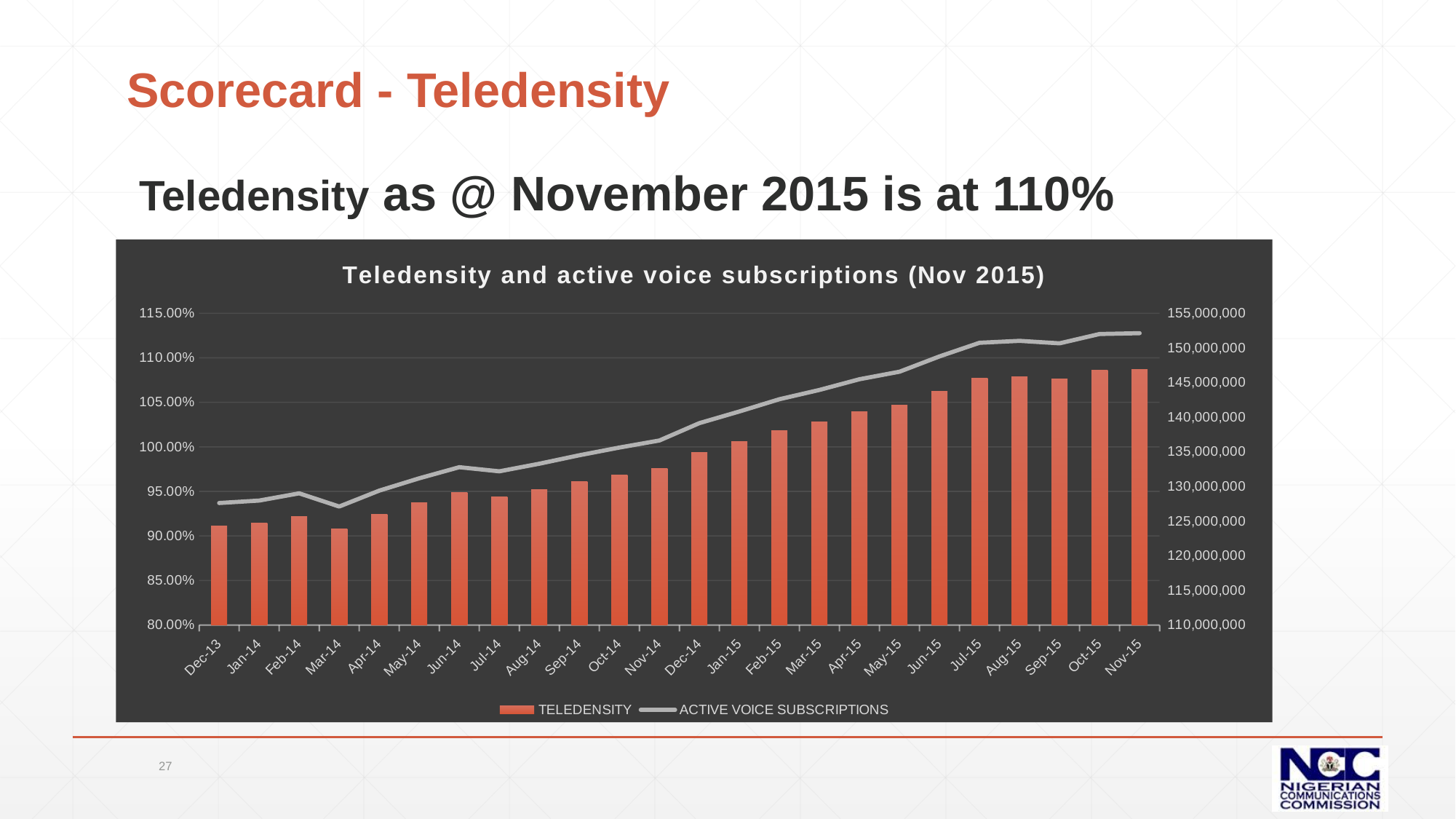
What type of chart is shown on the slide? Combination bar and line chart Is the active voice subscriptions value for Dec-13 greater or less than 130,000,000? less What is the title of the chart? Teledensity and active voice subscriptions (Nov 2015) Is the teledensity value for Nov-15 greater or less than 105.00%? greater Does teledensity generally rise or fall from Dec-13 to Nov-15? rise Is the teledensity value for Dec-13 greater or less than 95.00%? less Which series is drawn as a line in the chart? ACTIVE VOICE SUBSCRIPTIONS How many series does the chart legend list? 2 Which month has the higher teledensity, Mar-14 or Jun-14? Jun-14 How many months are plotted along the x axis of the chart? 24